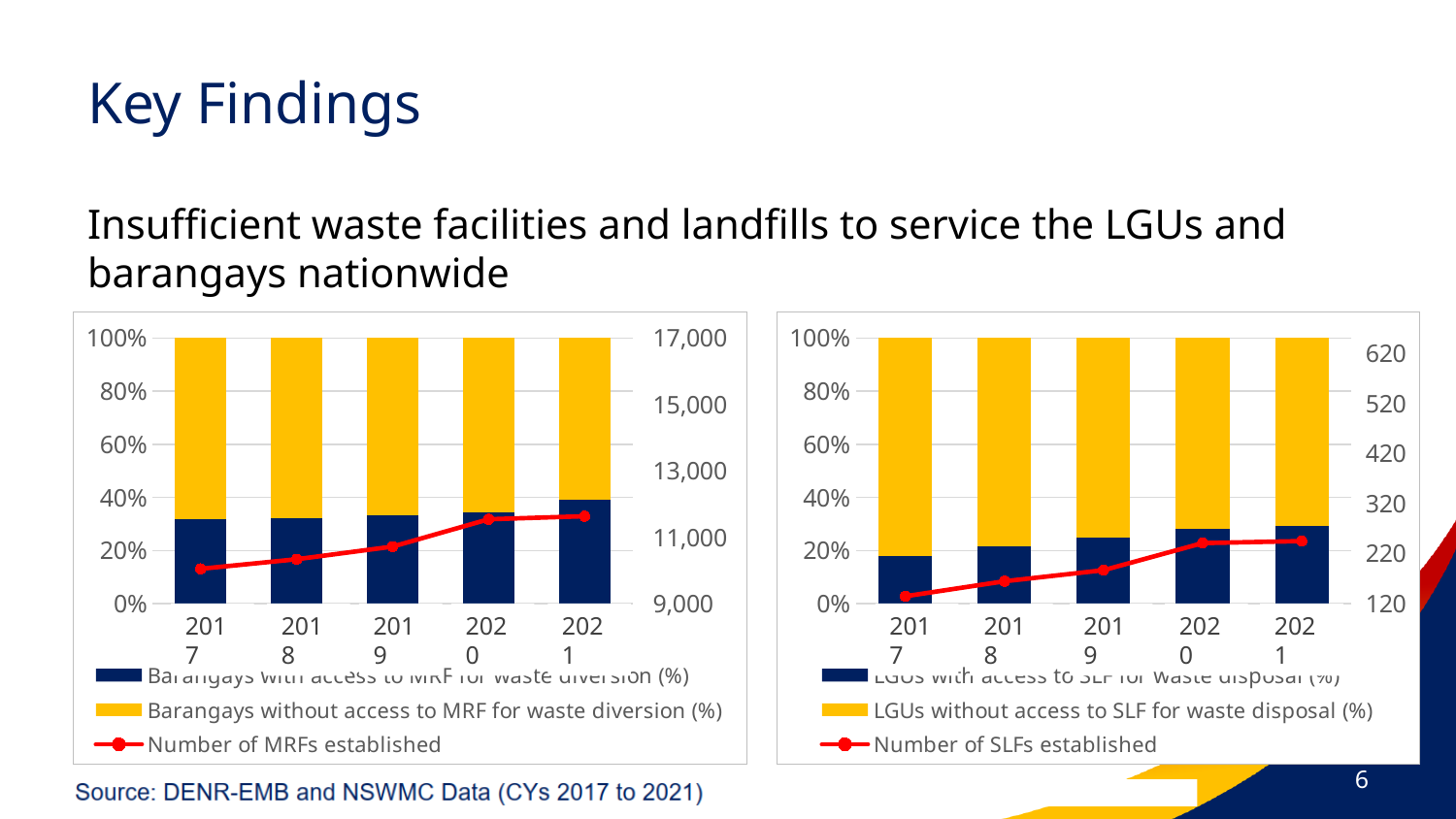
In the right chart, which year has the lowest share of LGUs with access to SLF for waste disposal? 2017 In the right chart, what is the label of the series drawn as a red line? Number of SLFs established How many series does the legend of the left chart list? 3 In the left chart, is the Number of MRFs established in 2021 greater or less than 11,000? greater What kind of chart is the left chart on the slide? A stacked bar chart with a line In the left chart, which year has the highest share of Barangays with access to MRF for waste diversion? 2021 In the right chart, does the Number of SLFs established line rise or fall from 2017 to 2021? Rise In the left chart, does the Number of MRFs established line rise or fall from 2017 to 2021? Rise In the right chart, is the Number of SLFs established in 2017 greater or less than 220? less In the left chart, is the Number of MRFs established in 2017 greater or less than 11,000? less How many years are shown on the x axis of the right chart? 5